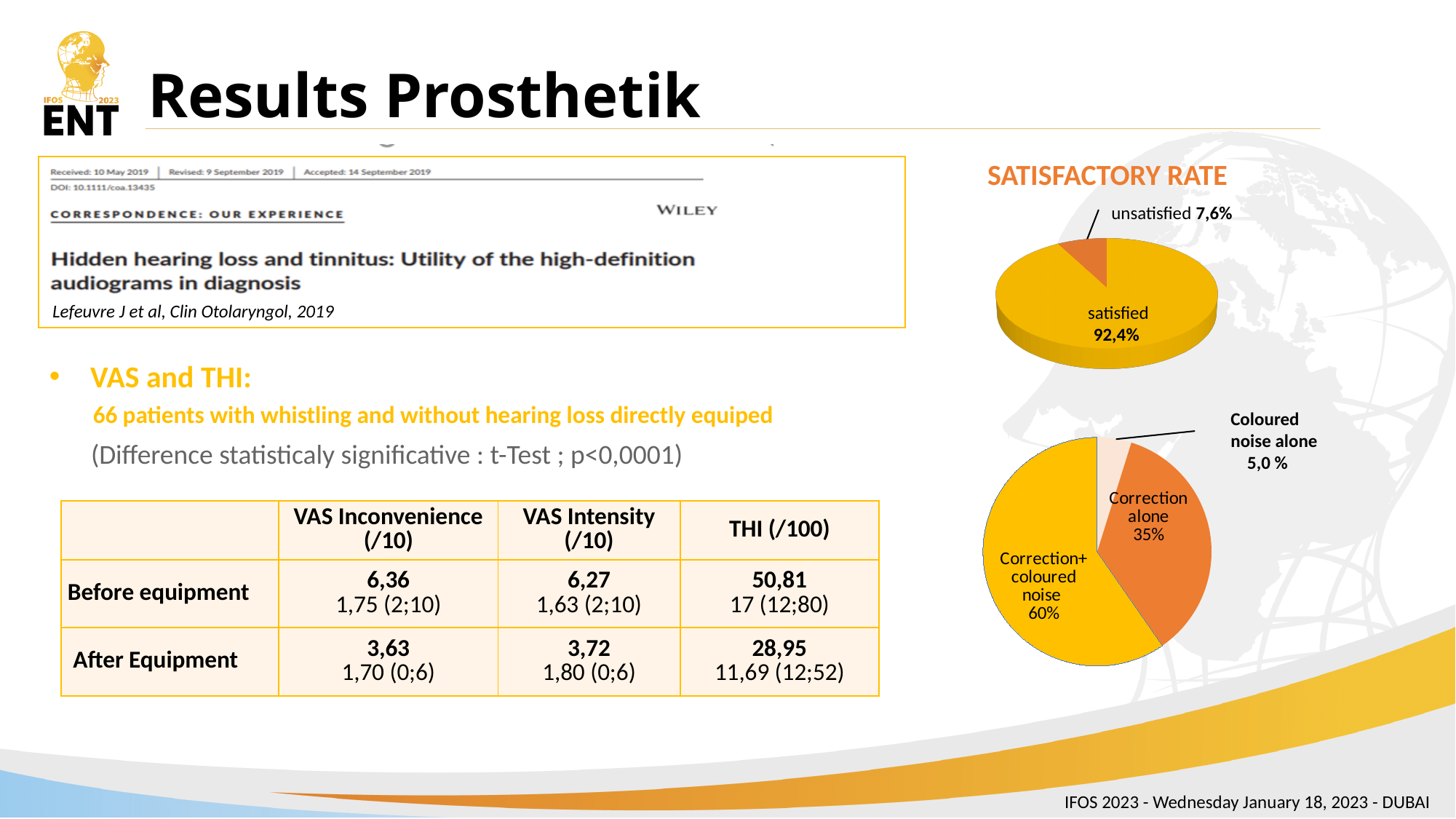
In the lower-right pie chart, which slice is the smallest? Coloured noise alone In the SATISFACTORY RATE pie chart, which slice is the largest? satisfied In the lower-right pie chart, what share is labelled Correction+coloured noise? 60% In the lower-right pie chart, what share is labelled Coloured noise alone? 5,0 % In the lower-right pie chart, which is larger: Correction alone or Correction+coloured noise? Correction+coloured noise In the SATISFACTORY RATE pie chart, what is the difference between the satisfied and unsatisfied shares? 84,8% What kind of chart is the SATISFACTORY RATE chart? pie chart In the SATISFACTORY RATE pie chart, how many slices are there? 2 In the SATISFACTORY RATE pie chart, what share of patients were satisfied? 92,4% In the lower-right pie chart, how many slices are there? 3 In the lower-right pie chart, what share is labelled Correction alone? 35% In the SATISFACTORY RATE pie chart, what share of patients were unsatisfied? 7,6%